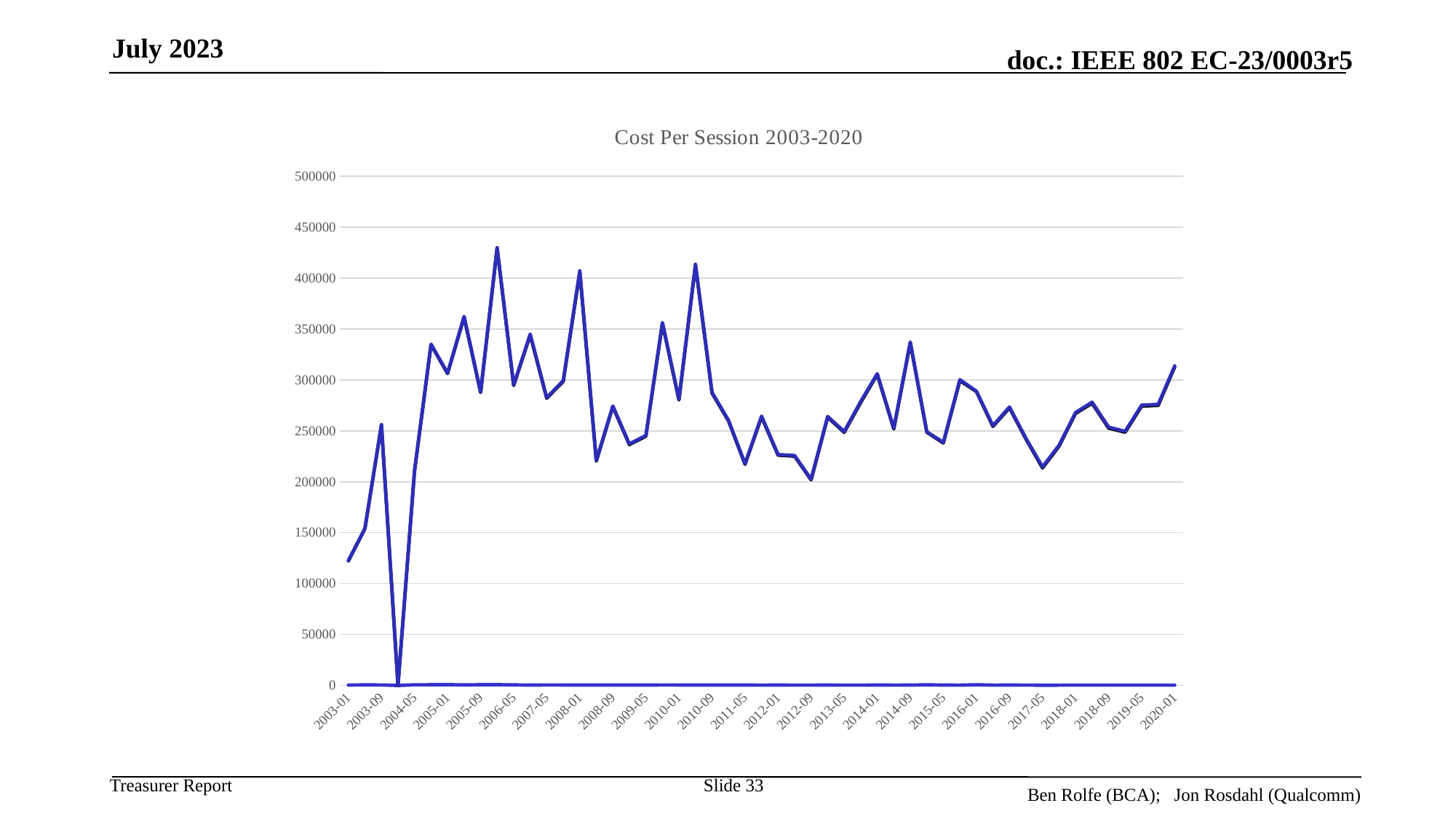
Is the value for 2017-05 greater or less than 250000? less What is the highest value shown on the y axis? 500000 Is the value for 2008-01 greater or less than 350000? greater Which has the higher cost per session, 2003-01 or 2020-01? 2020-01 What is the title of the chart? Cost Per Session 2003-2020 Is the value for 2014-09 greater or less than 300000? greater Between 2003-01 and 2003-09, does the line rise or fall? rise What kind of chart is shown on the slide? line chart